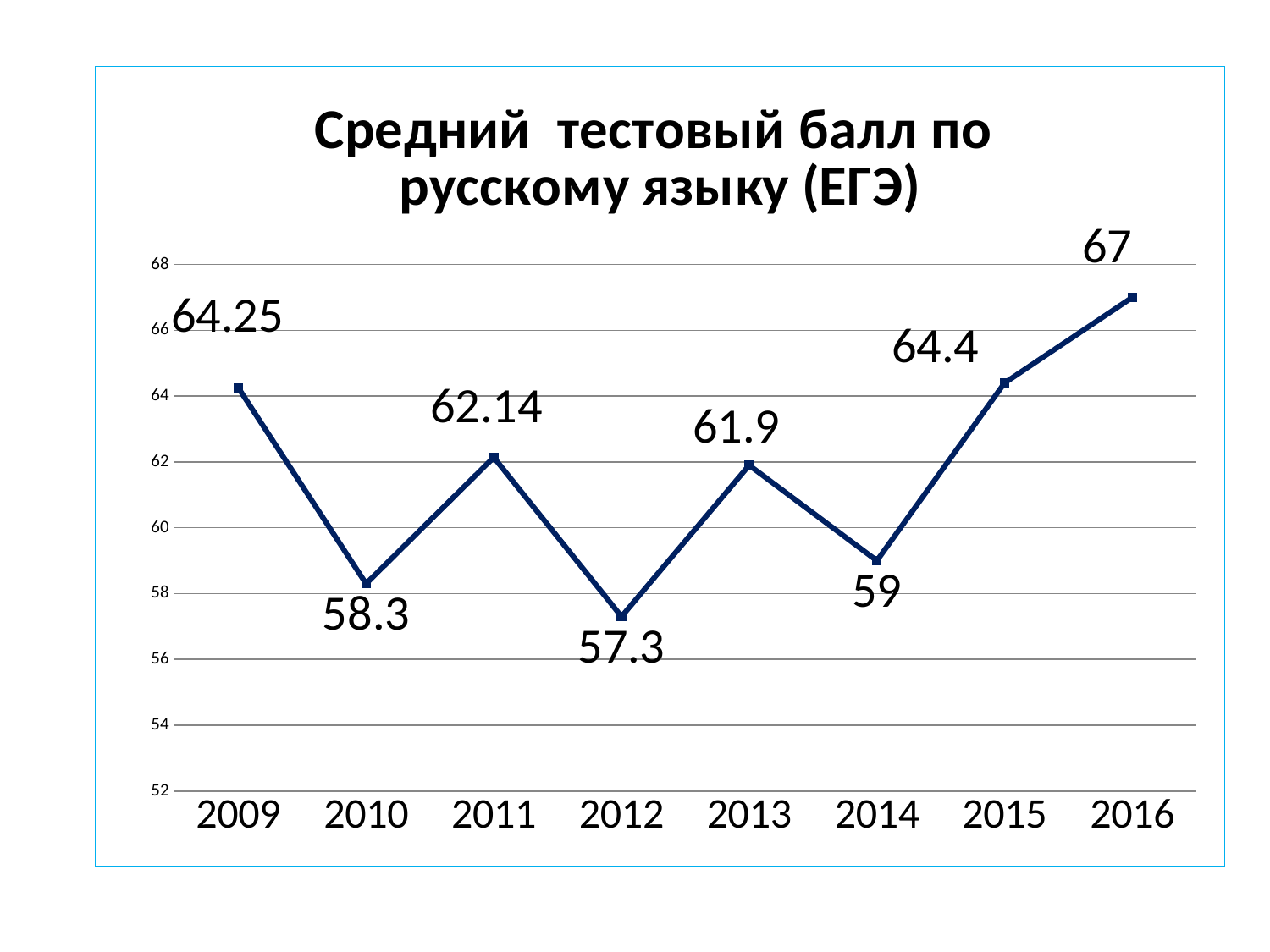
How many years are plotted on the chart? 8 What is the difference between the scores for 2011 and 2010? 3.84 Do the values rise or fall from 2014 to 2016? rise What is the difference between the scores for 2016 and 2015? 2.6 What is the average test score for 2015? 64.4 Which year has a higher score, 2013 or 2014? 2013 What is the average test score for 2012? 57.3 What kind of chart is shown on the slide? line chart Which year has the highest average test score? 2016 Which year has the lowest average test score? 2012 Is the value for 2014 greater or less than 60? less What is the average test score for 2009? 64.25